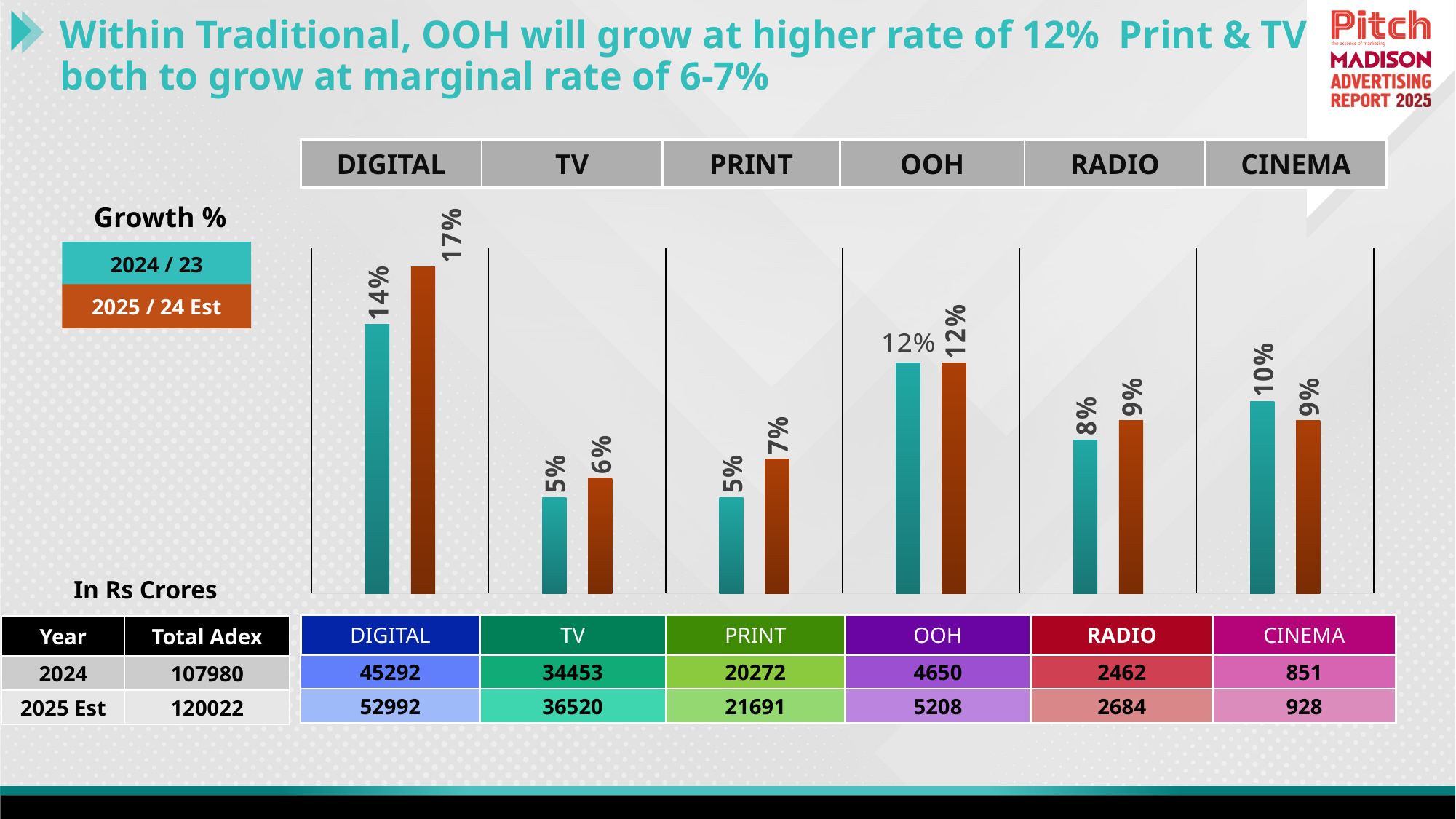
What is the 2024 / 23 growth % for RADIO? 8% How many categories are shown in the growth % chart? 6 Which category has the lowest 2025 / 24 Est growth %? TV What kind of chart is used to show the growth %? Bar chart Which category has the highest 2025 / 24 Est growth %? DIGITAL What is the difference between the 2025 / 24 Est and 2024 / 23 growth % for DIGITAL? 3% What is the 2025 / 24 Est growth % for PRINT? 7% What is the 2024 / 23 growth % for OOH? 12% Which colour represents the 2025 / 24 Est series in the legend? Orange-brown Which is larger for CINEMA: the 2024 / 23 growth % or the 2025 / 24 Est growth %? 2024 / 23 How many series does the legend list? 2 What is the 2025 / 24 Est growth % for DIGITAL? 17%